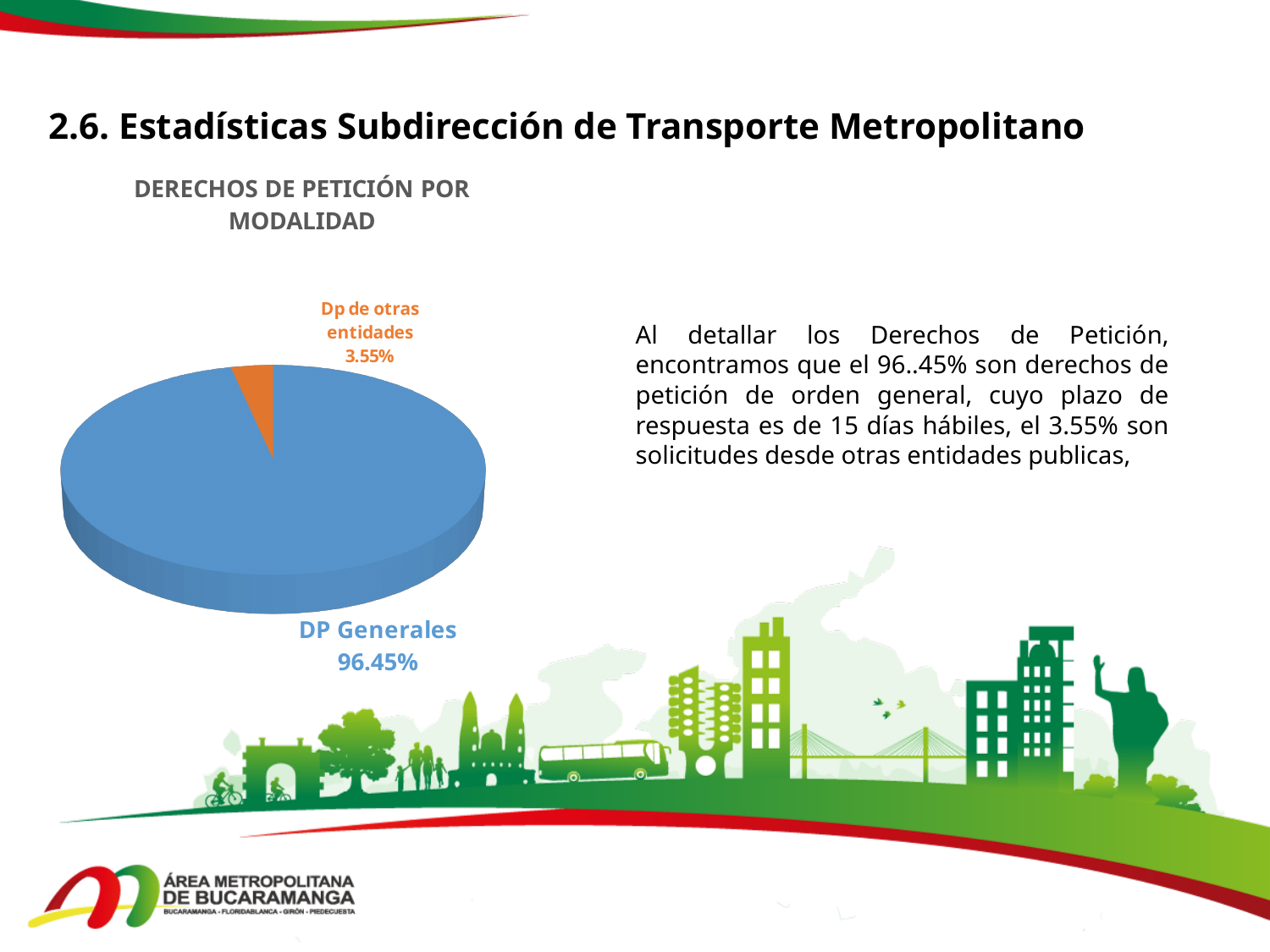
What is the difference in percentage points between DP Generales and Dp de otras entidades? 92.90% Which category has the largest slice of the pie? DP Generales What share of the pie does DP Generales represent? 96.45% What is the title of the chart? DERECHOS DE PETICIÓN POR MODALIDAD Which is larger, the share for DP Generales or the share for Dp de otras entidades? DP Generales Which category has the smallest slice of the pie? Dp de otras entidades What share of the pie does Dp de otras entidades represent? 3.55% How many categories are shown in the pie chart? 2 What kind of chart is shown on the slide? Pie chart What colour is the slice for DP Generales? Blue